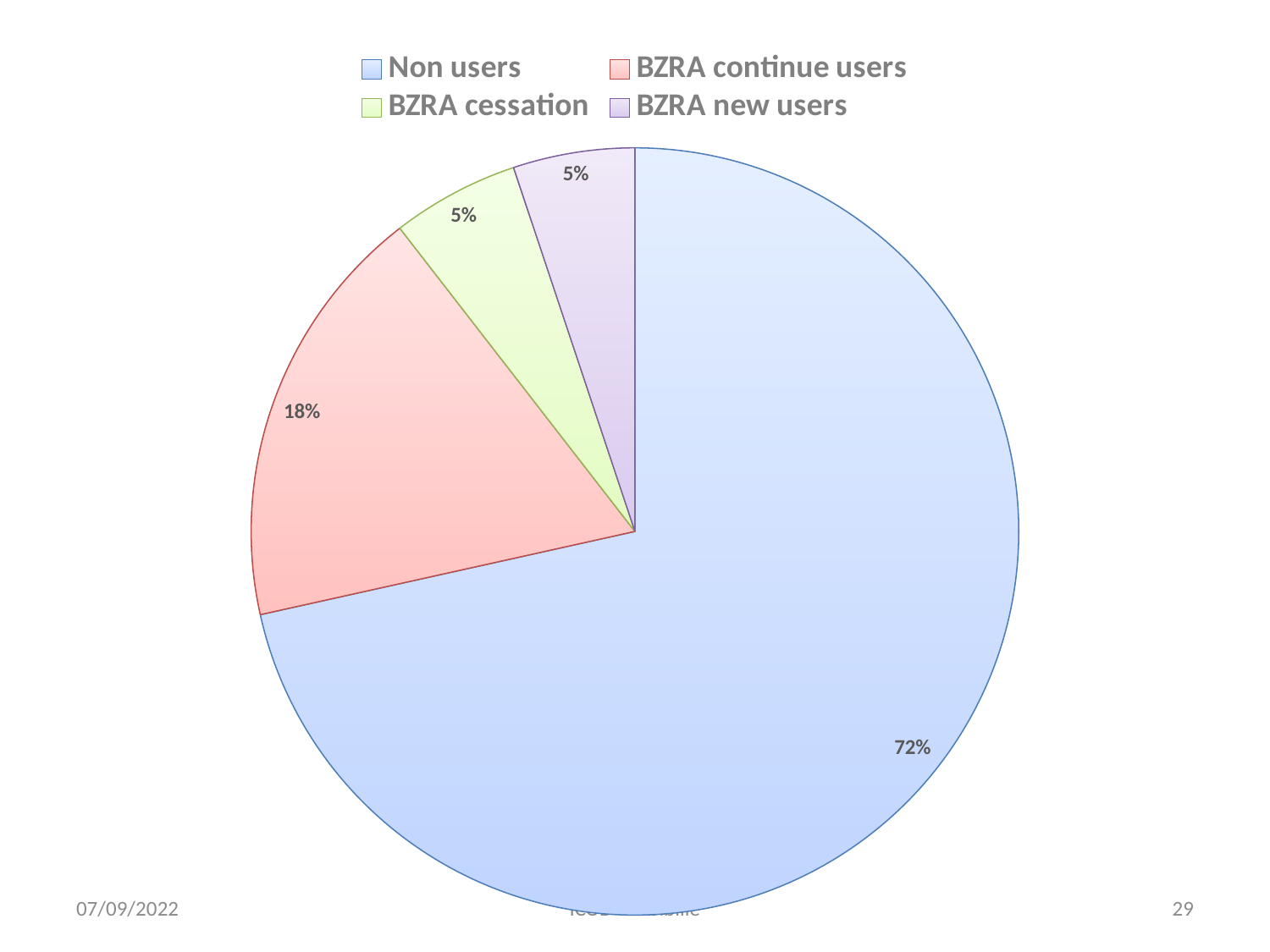
What share of the pie is labelled for BZRA new users? 5% How many categories does the legend list? 4 What is the difference in percentage points between the Non users slice and the BZRA continue users slice? 54 What kind of chart is shown on the slide? pie chart Which slice is larger, BZRA continue users or BZRA cessation? BZRA continue users What share of the pie is labelled for Non users? 72% Which category has the largest slice of the pie? Non users What colour is the Non users slice? blue What share of the pie is labelled for BZRA continue users? 18% Is the share for Non users greater or less than 50%? greater What share of the pie is labelled for BZRA cessation? 5% What colour is the BZRA cessation slice? green